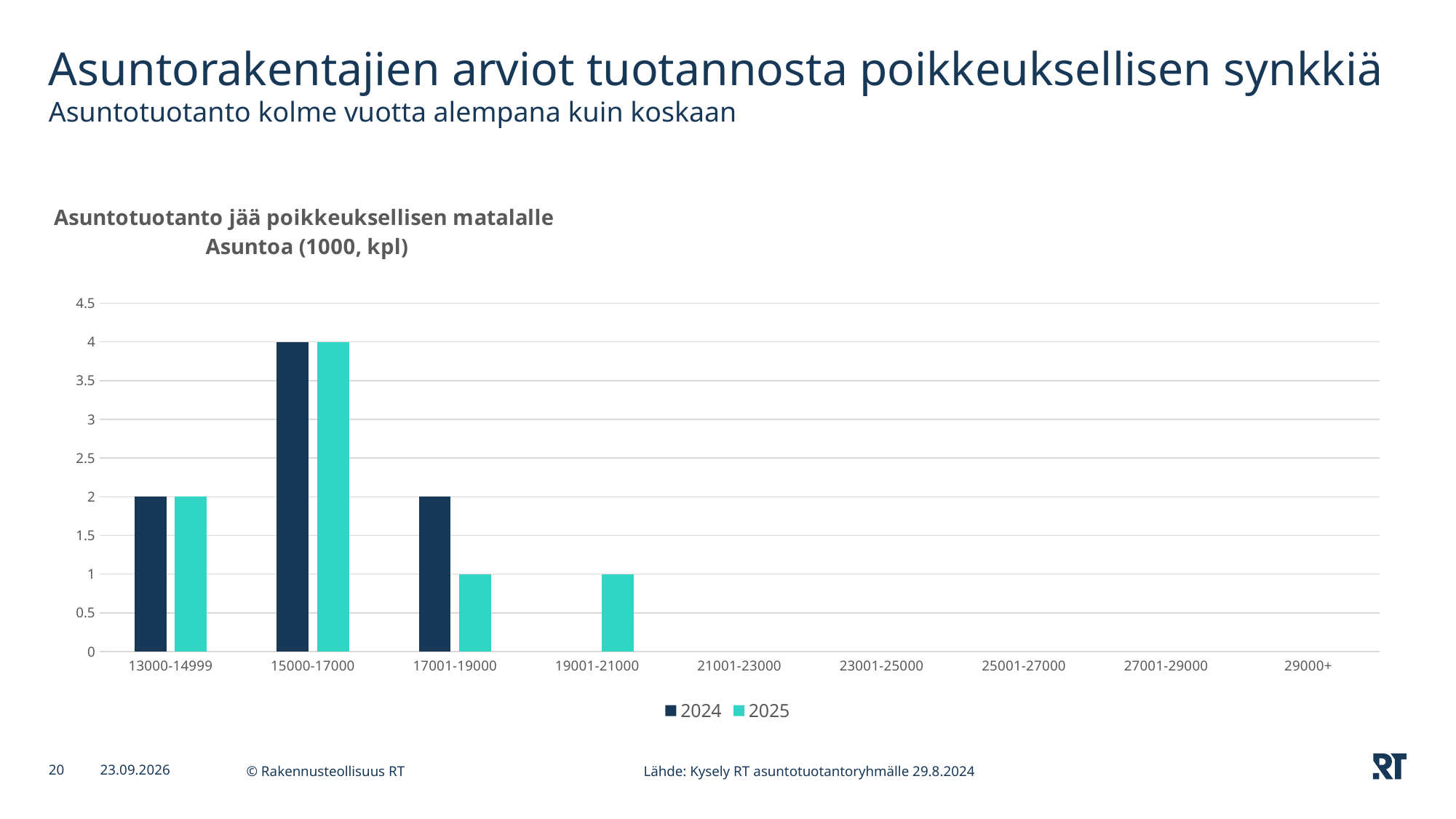
What is the value for 2025 in the 19001-21000 category? 1 Which category has the highest value for the 2025 series? 15000-17000 Which is larger in the 17001-19000 category, the 2024 value or the 2025 value? 2024 What is the value for 2025 in the 17001-19000 category? 1 What is the difference between the 2024 and 2025 values in the 17001-19000 category? 1 What is the value for 2024 in the 13000-14999 category? 2 How many categories are shown on the x axis? 9 What is the value for 2024 in the 15000-17000 category? 4 What kind of chart is shown on the slide? bar chart How many series does the legend list? 2 What is the title of the chart? Asuntotuotanto jää poikkeuksellisen matalalle Asuntoa (1000, kpl) Is the value for 2024 in the 15000-17000 category greater or less than 3? greater